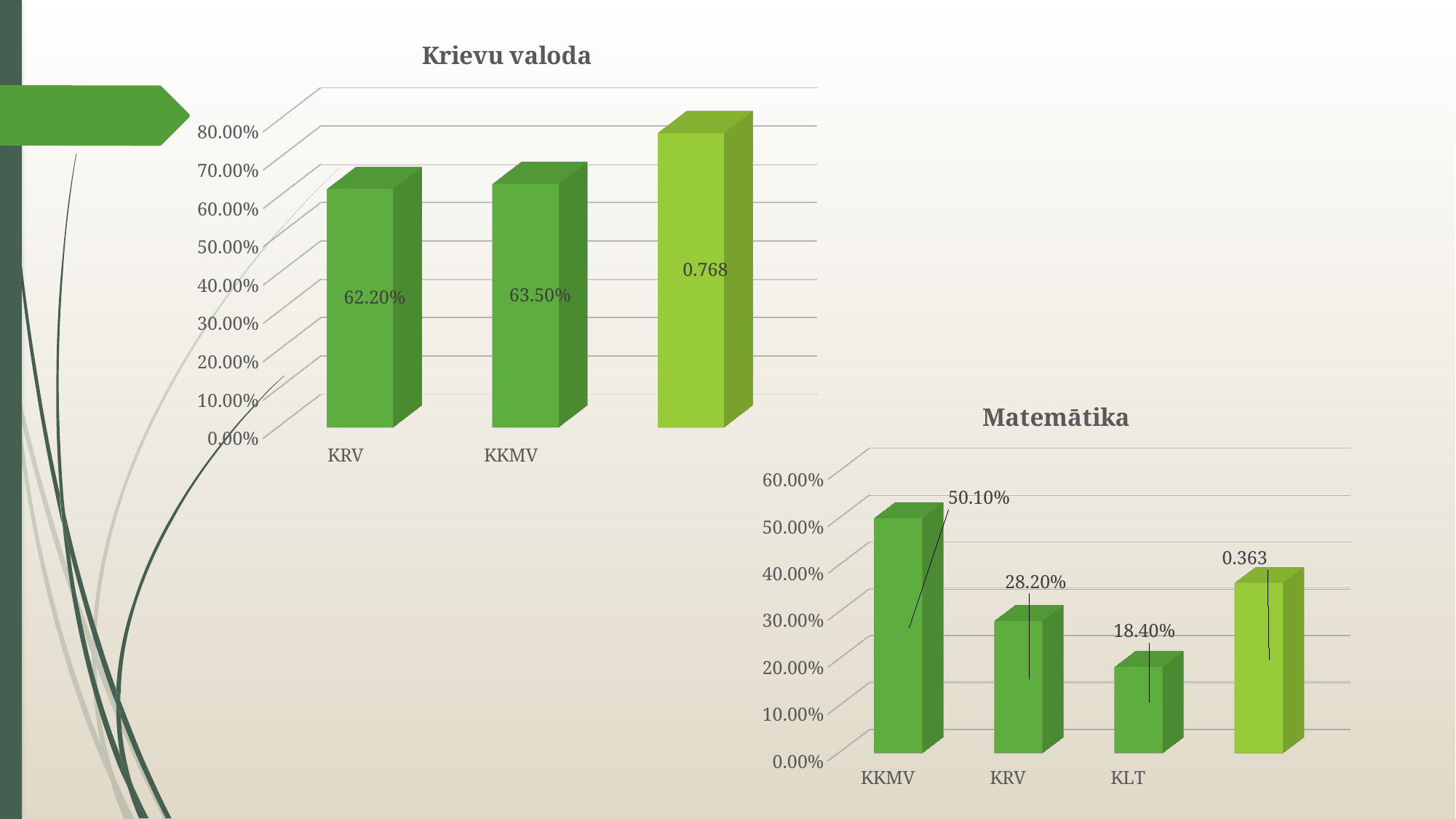
In the Matemātika chart, what is the value for KLT? 18.40% In the Krievu valoda chart, which is larger, KRV or KKMV? KKMV In the Matemātika chart, which category has the lowest value? KLT What kind of chart is the Krievu valoda chart? Bar chart In the Matemātika chart, which category has the highest value? KKMV In the Matemātika chart, what is the difference between the KKMV and KRV values? 21.90% In the Krievu valoda chart, what is the difference between the KKMV and KRV values? 1.30% How many bars are plotted in the Matemātika chart? 4 In the Krievu valoda chart, what is the value for KKMV? 63.50% In the Matemātika chart, what is the value for KRV? 28.20% In the Matemātika chart, what is the value for KKMV? 50.10% In the Krievu valoda chart, what is the value for KRV? 62.20%